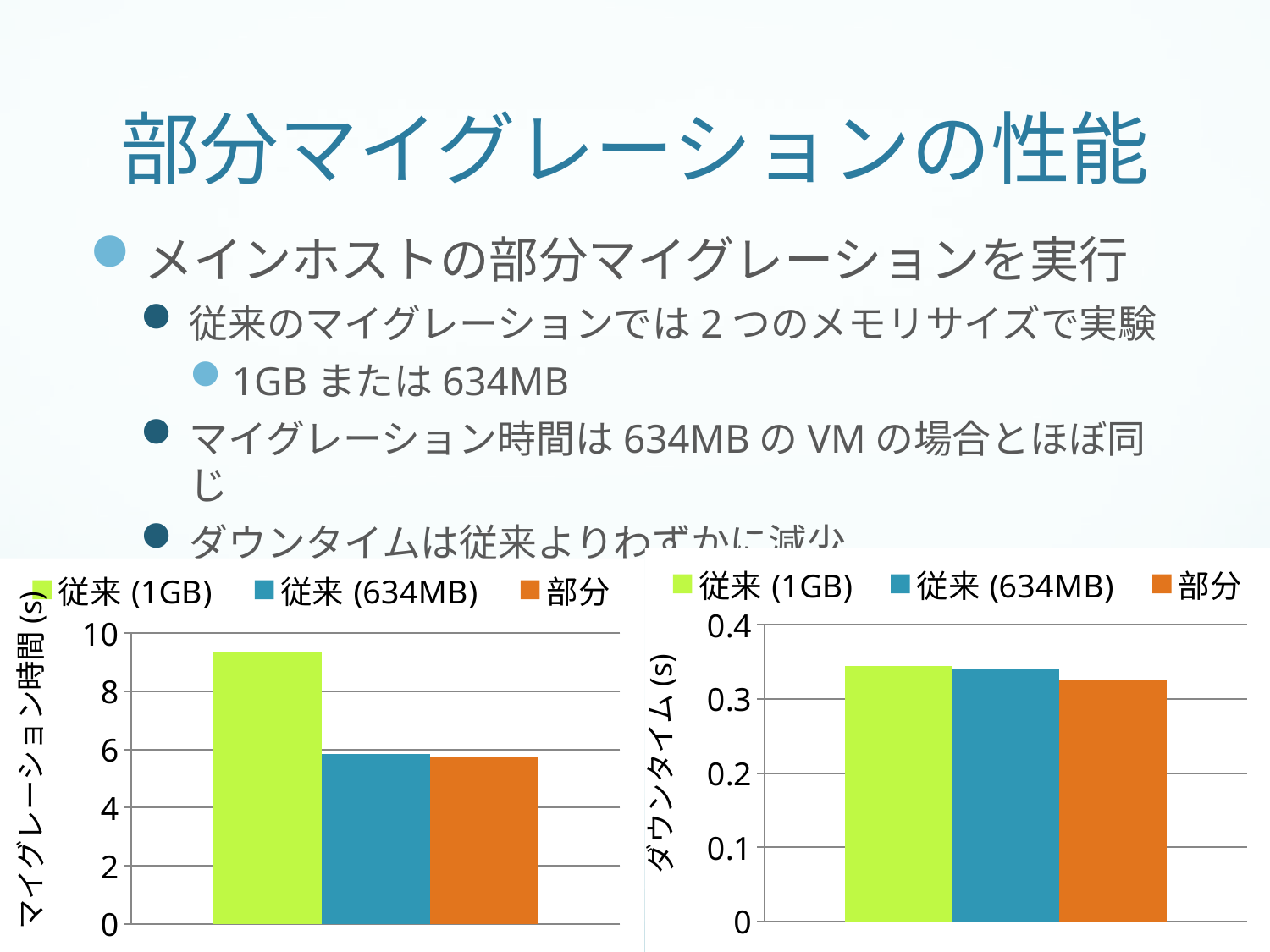
On the right chart (ダウンタイム), is the value for 従来 (1GB) greater or less than 0.3? greater On the right chart (ダウンタイム), is the value for 部分 greater or less than 0.4? less On the left chart (マイグレーション時間), is the value for 従来 (1GB) greater or less than 8? greater On the right chart (ダウンタイム), which is larger, 従来 (1GB) or 部分? 従来 (1GB) How many bars are plotted on the right chart (ダウンタイム)? 3 What kind of chart is the left chart (マイグレーション時間)? bar chart On the left chart (マイグレーション時間), which series has the highest value? 従来 (1GB) How many series does the legend of the left chart (マイグレーション時間) list? 3 On the left chart (マイグレーション時間), which is larger, 従来 (1GB) or 部分? 従来 (1GB) What is the y-axis label of the right chart? ダウンタイム (s)